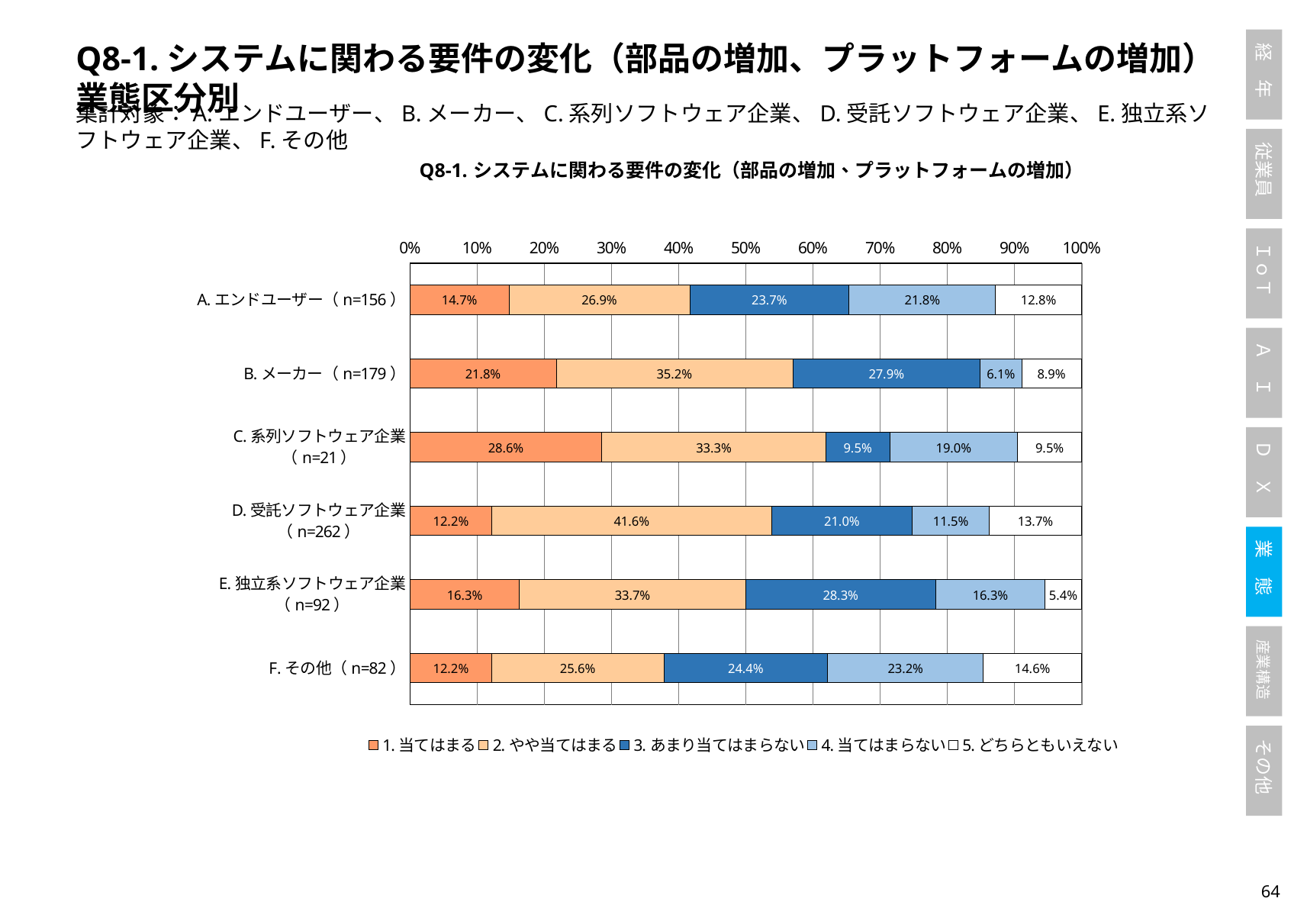
Is the combined share of 1. 当てはまる and 2. やや当てはまる for D. 受託ソフトウェア企業 greater or less than 50%? greater What percentage of A. エンドユーザー (n=156) answered 1. 当てはまる? 14.7% Which has a larger share of 4. 当てはまらない: A. エンドユーザー or D. 受託ソフトウェア企業? A. エンドユーザー Which category has the highest share of 2. やや当てはまる? D. 受託ソフトウェア企業 (n=262) What kind of chart is shown on the slide? Stacked bar chart What percentage of D. 受託ソフトウェア企業 (n=262) answered 2. やや当てはまる? 41.6% What percentage of B. メーカー (n=179) answered 4. 当てはまらない? 6.1% For A. エンドユーザー, what is the difference between the 2. やや当てはまる share and the 1. 当てはまる share? 12.2% Which category has the highest share of 1. 当てはまる? C. 系列ソフトウェア企業 (n=21) How many series does the legend list? 5 Which category has the lowest share of 4. 当てはまらない? B. メーカー (n=179) How many categories (業態) are shown on the chart? 6